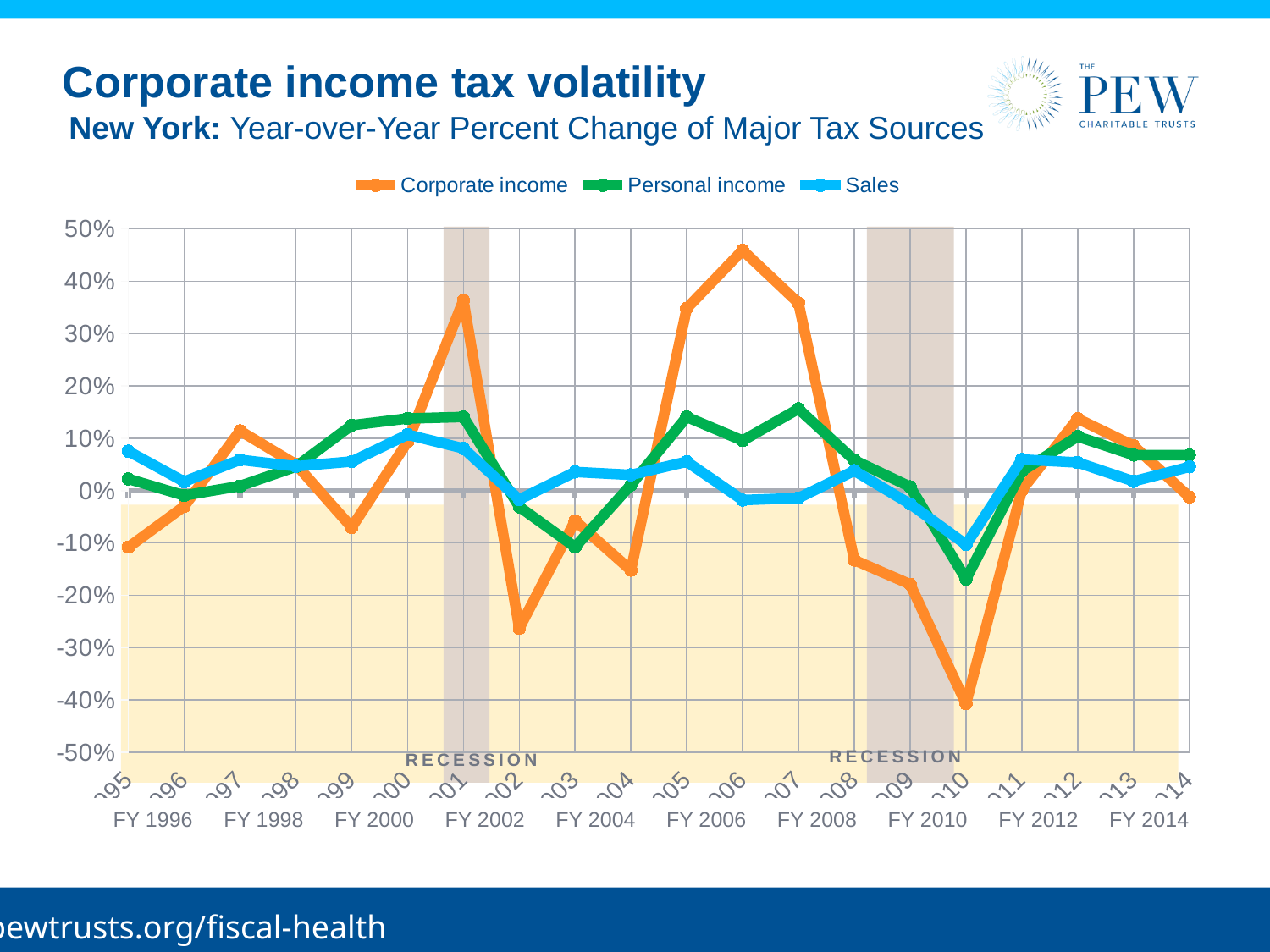
Is the Corporate income value for FY 2006 greater or less than 40%? greater Is the Corporate income value for FY 2010 greater or less than -30%? less Which series are listed in the legend? Corporate income, Personal income, Sales In which fiscal year does the Corporate income line reach its lowest point? FY 2010 What kind of chart is shown on the slide? Line chart In FY 2006, which is larger: the Corporate income value or the Personal income value? Corporate income In which fiscal year does the Corporate income line reach its highest point? FY 2006 Which series has the lowest value in FY 2010? Corporate income Is the Corporate income value for FY 2002 greater or less than -20%? less How many series does the legend list? 3 Which series reaches the highest value on the chart? Corporate income